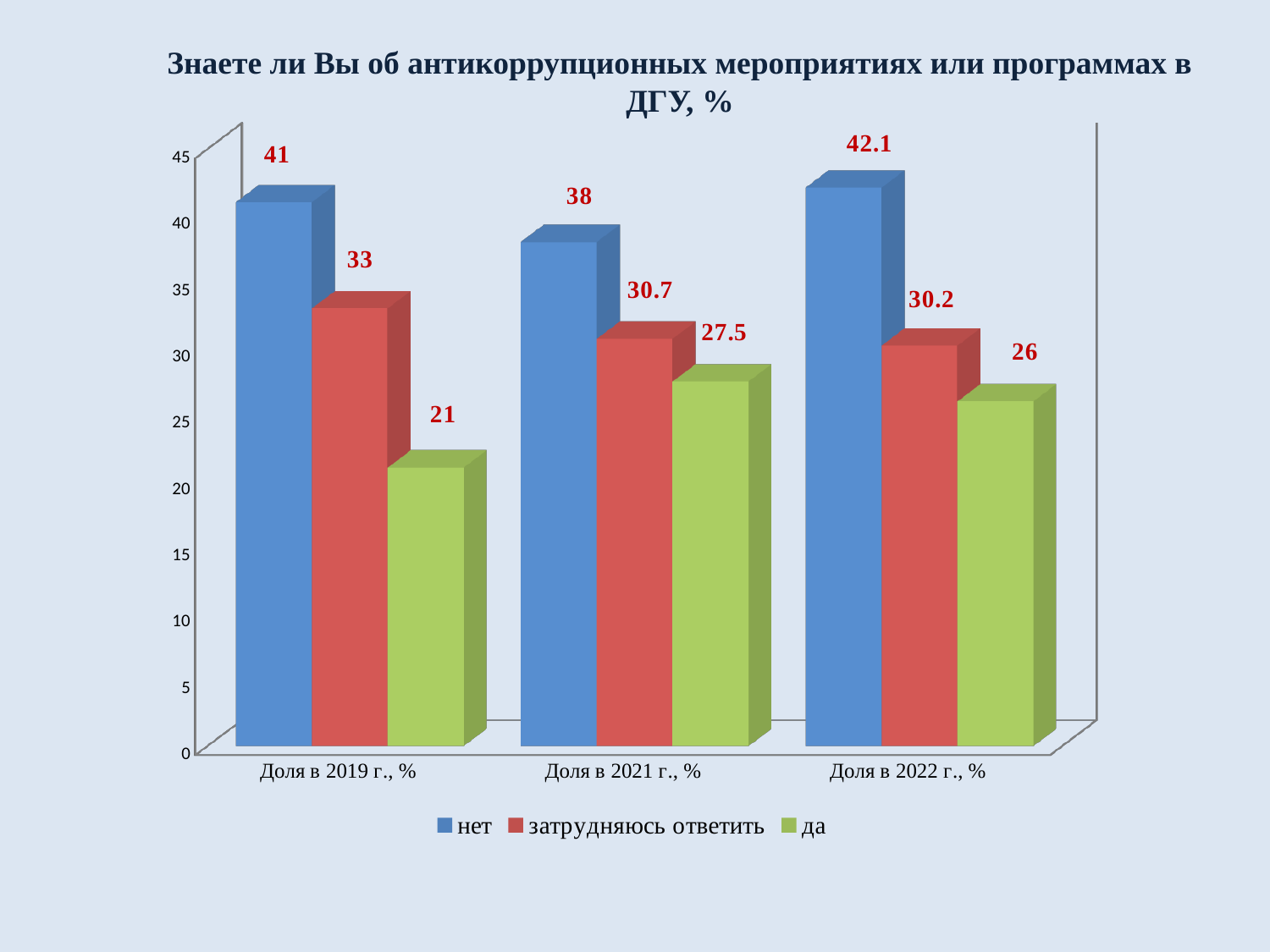
How many categories are shown on the x axis? 3 Which is larger: "затрудняюсь ответить" in "Доля в 2021 г., %" or "затрудняюсь ответить" in "Доля в 2019 г., %"? Доля в 2019 г., % In which category is the value for "да" lowest? Доля в 2019 г., % In which category is the value for "нет" highest? Доля в 2022 г., % What is the value for "нет" in "Доля в 2019 г., %"? 41 What colour represents the "да" series? green How many series does the legend list? 3 What is the difference between the "нет" and "да" values in "Доля в 2019 г., %"? 20 What is the value for "да" in "Доля в 2021 г., %"? 27.5 What is the value for "затрудняюсь ответить" in "Доля в 2022 г., %"? 30.2 Does the value for "да" rise or fall from "Доля в 2019 г., %" to "Доля в 2022 г., %"? rise What kind of chart is shown on the slide? bar chart